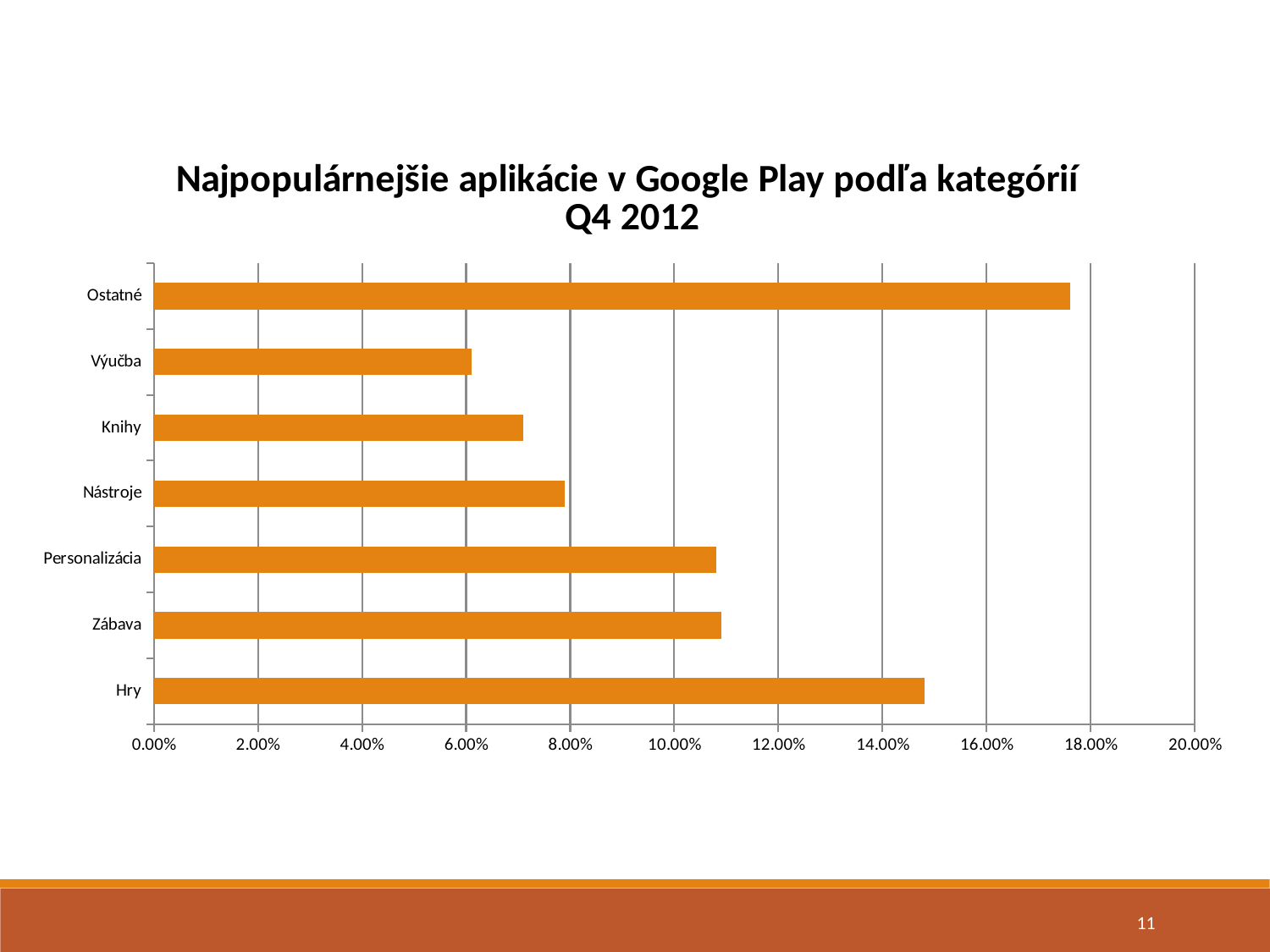
Which has a larger value, Hry or Zábava? Hry Is the value for Ostatné greater or less than 16.00%? greater Which category has the highest value? Ostatné Which category has the lowest value? Výučba What is the title of the chart? Najpopulárnejšie aplikácie v Google Play podľa kategórií Q4 2012 Which has a larger value, Ostatné or Hry? Ostatné Is the value for Zábava greater or less than 12.00%? less Is the value for Výučba greater or less than 8.00%? less What type of chart is shown on the slide? bar chart How many categories are shown in the chart? 7